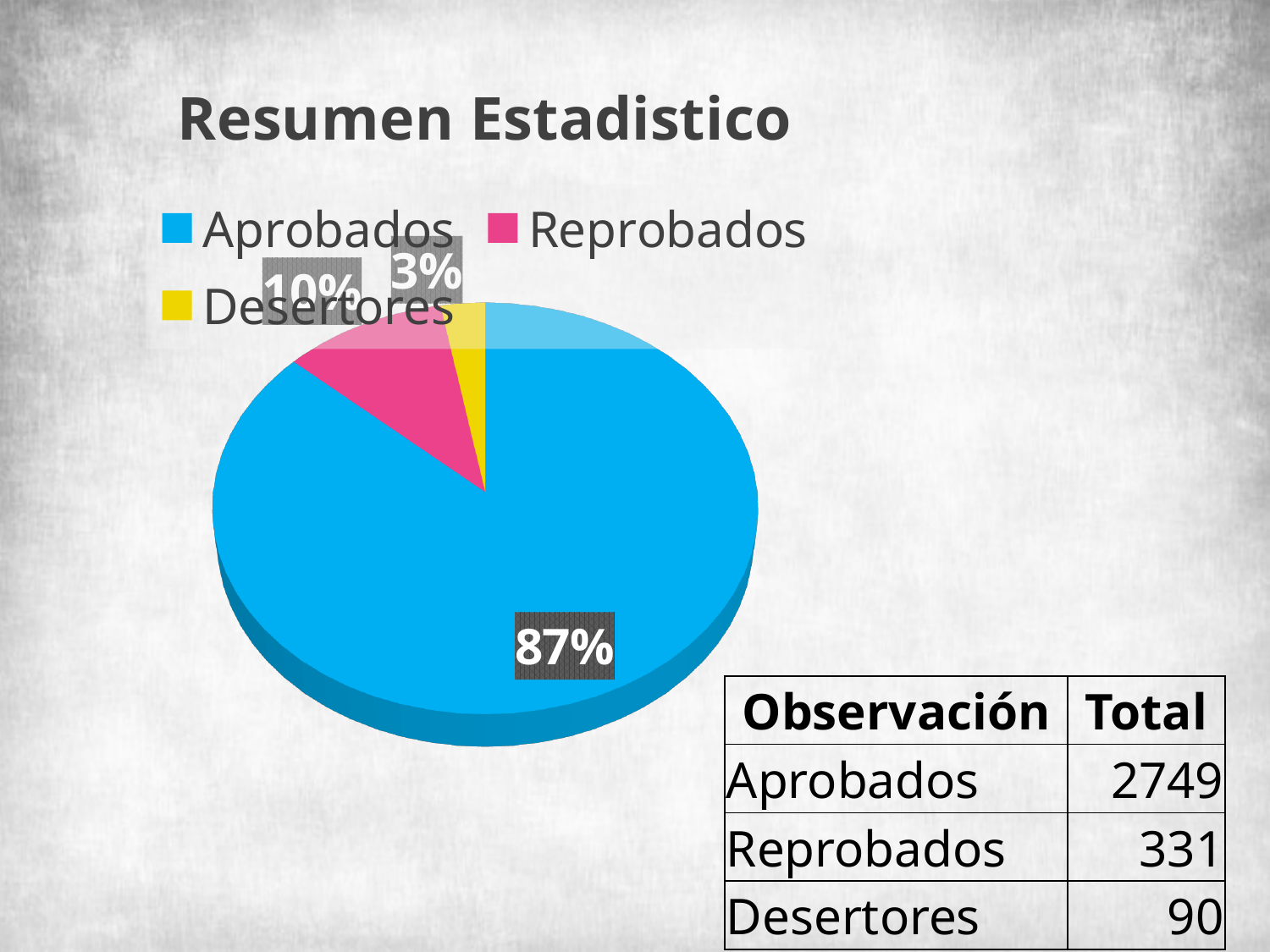
Which category has the largest slice of the pie? Aprobados What colour is the Aprobados slice in the pie chart? blue What share of the pie does Reprobados represent? 10% Which category has the smallest slice of the pie? Desertores Which slice is larger, Reprobados or Desertores? Reprobados What kind of chart is shown on the slide? pie chart How many slices does the pie chart have? 3 What share of the pie does Aprobados represent? 87% What is the difference in percentage points between the Aprobados slice and the Reprobados slice? 77 percentage points What is the title of the slide containing the pie chart? Resumen Estadistico How many entries does the chart legend list? 3 What share of the pie does Desertores represent? 3%